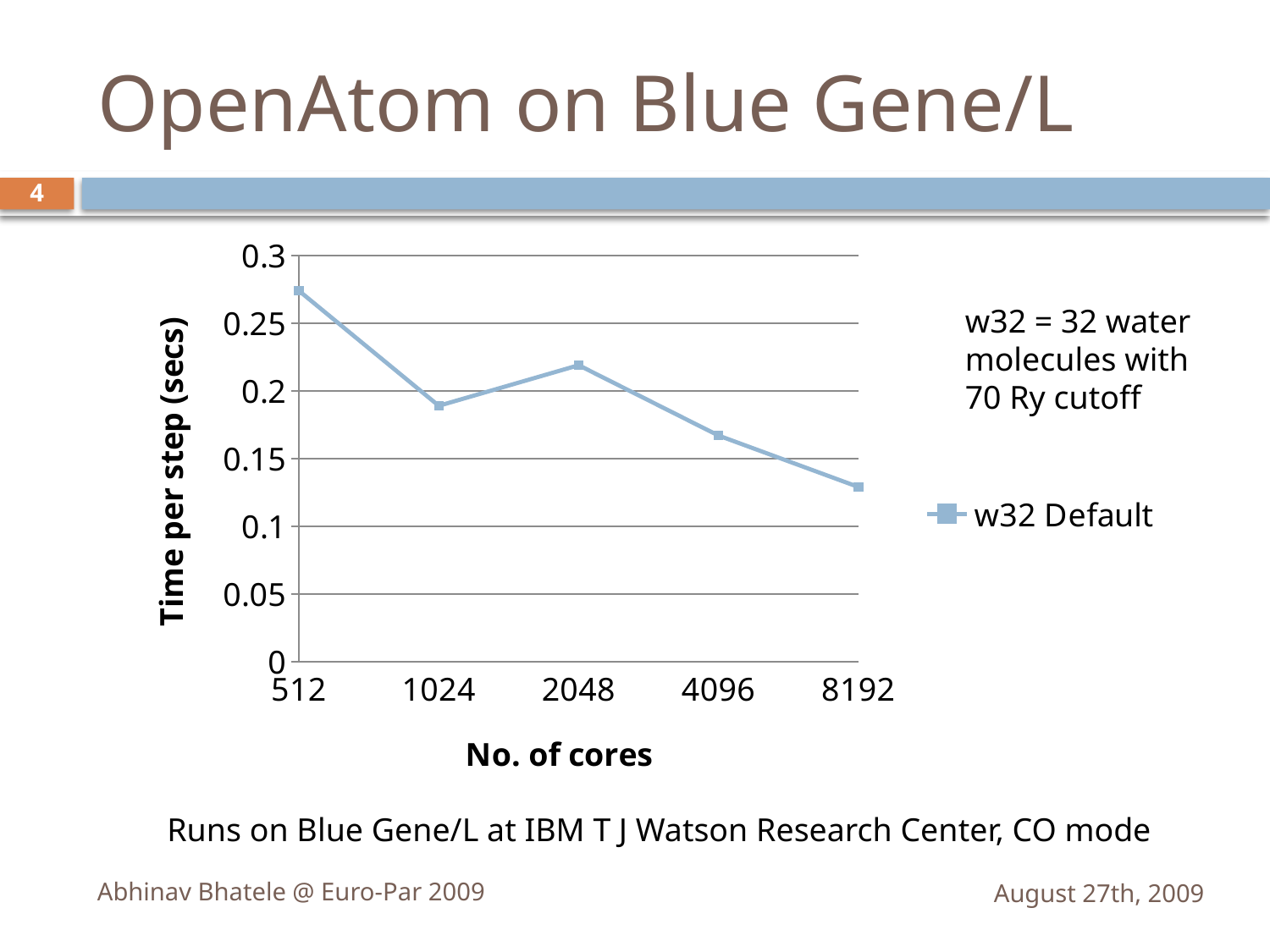
Does the time per step generally rise or fall as the number of cores increases from 512 to 8192? fall Is the time per step at 2048 cores greater or less than 0.2? greater What is the label of the series shown in the legend? w32 Default How many series does the legend list? 1 How many data points are plotted on the line? 5 Is the time per step at 512 cores greater or less than 0.25? greater Is the time per step at 4096 cores greater or less than 0.15? greater At which number of cores is the time per step lowest? 8192 Which has a higher time per step: 1024 cores or 2048 cores? 2048 cores At which number of cores is the time per step highest? 512 What kind of chart is shown on the slide? line chart